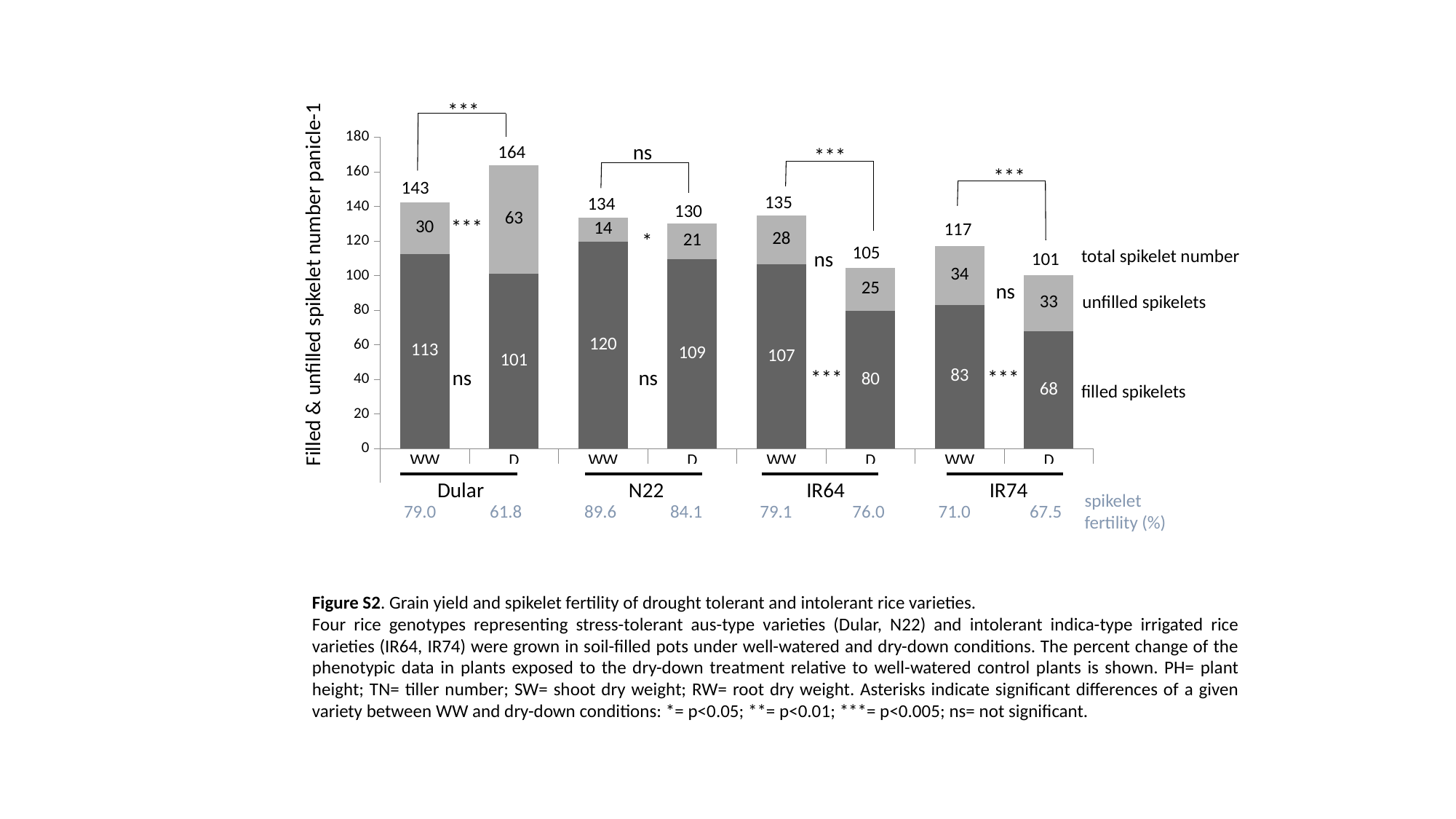
What type of chart is shown? Stacked bar chart What is the spikelet fertility (%) for N22 under WW conditions? 89.6 What is the number of unfilled spikelets for Dular under D conditions? 63 How many bars are plotted in the chart? 8 What is the number of filled spikelets for Dular under WW conditions? 113 Which bar has the highest total spikelet number? Dular D What is the total spikelet number for N22 under WW conditions? 134 What is the y-axis label of the chart? Filled & unfilled spikelet number panicle-1 What is the difference in filled spikelets between IR64 WW and IR64 D? 27 Which has more unfilled spikelets, N22 WW or IR74 WW? IR74 WW What is the number of filled spikelets for IR74 under D conditions? 68 Which bar has the lowest total spikelet number? IR74 D